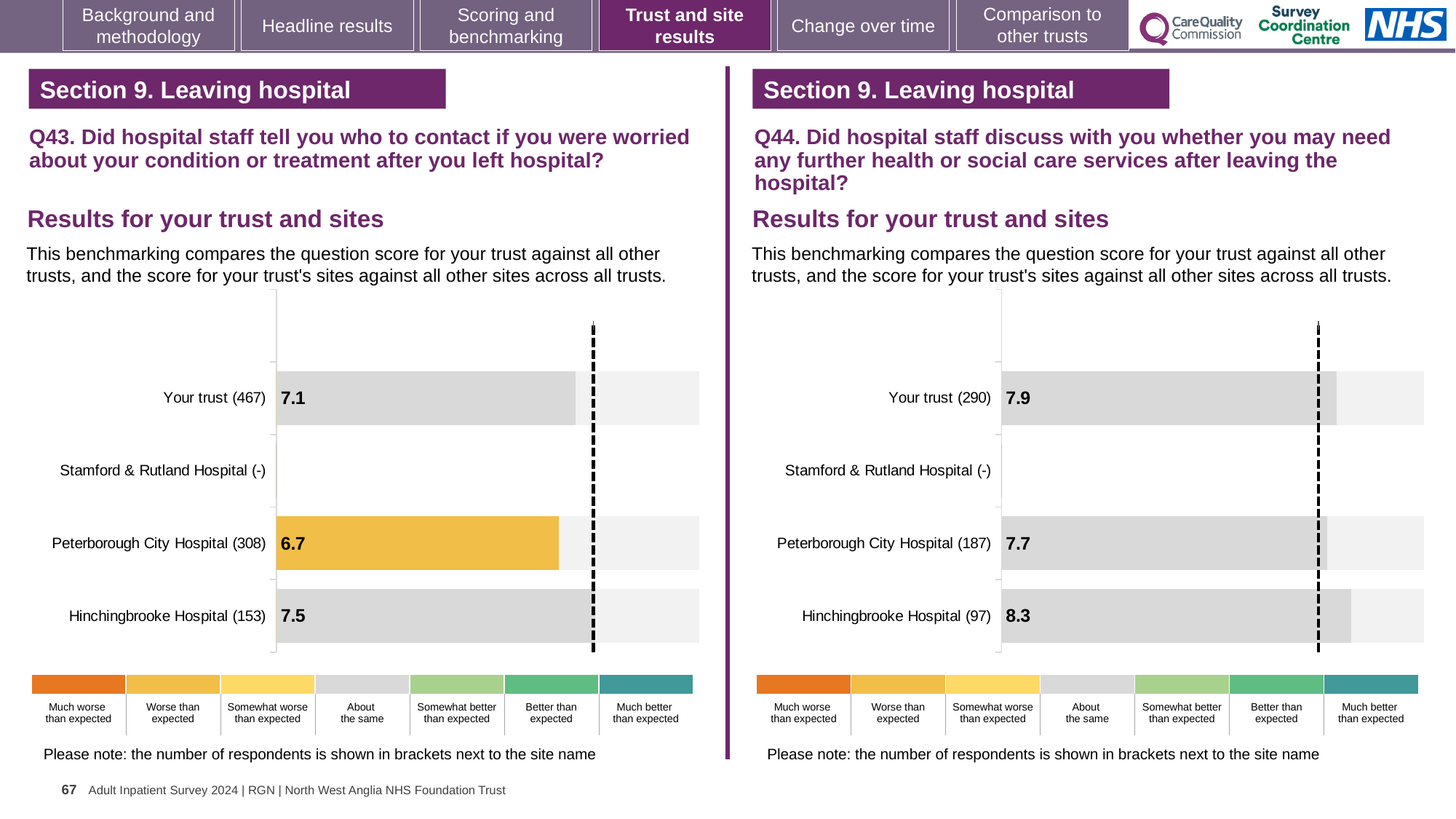
On the Q43 chart (left), which site has the highest score? Hinchingbrooke Hospital On the Q43 chart (left), how many respondents are shown for Your trust? 467 On the Q43 chart (left), how many categories are listed on the vertical axis? 4 On the Q44 chart (right), what is the score for Hinchingbrooke Hospital? 8.3 What kind of chart is used on the Q43 chart (left)? bar chart On the Q44 chart (right), which site has the lowest score among those with a plotted bar? Peterborough City Hospital On the Q43 chart (left), what is the score for Your trust? 7.1 On the Q44 chart (right), what is the score for Your trust? 7.9 On the Q43 chart (left), what is the difference between the scores for Hinchingbrooke Hospital and Peterborough City Hospital? 0.8 On the Q44 chart (right), what is the difference between the scores for Hinchingbrooke Hospital and Your trust? 0.4 On the Q44 chart (right), is the score for Your trust larger or smaller than the score for Peterborough City Hospital? larger On the Q43 chart (left), what is the score for Peterborough City Hospital? 6.7